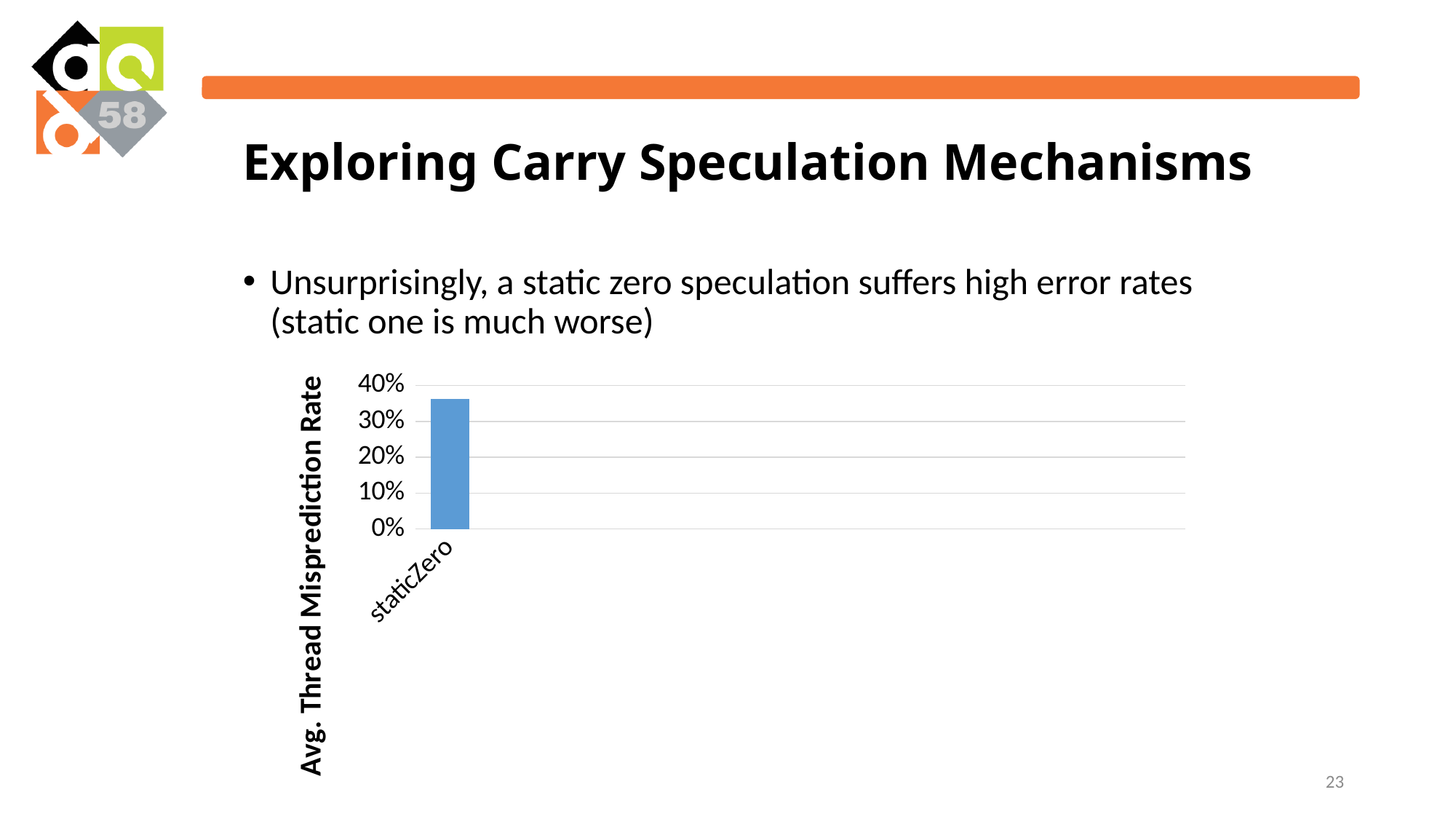
Is the value for staticZero greater or less than 10%? greater Is the value for staticZero greater or less than 20%? greater Is the value for staticZero greater or less than 30%? greater What is the label of the y axis of the chart? Avg. Thread Misprediction Rate How many bars are plotted in the chart? 1 What kind of chart is shown on the slide? bar chart What is the name of the only category shown on the x axis of the chart? staticZero